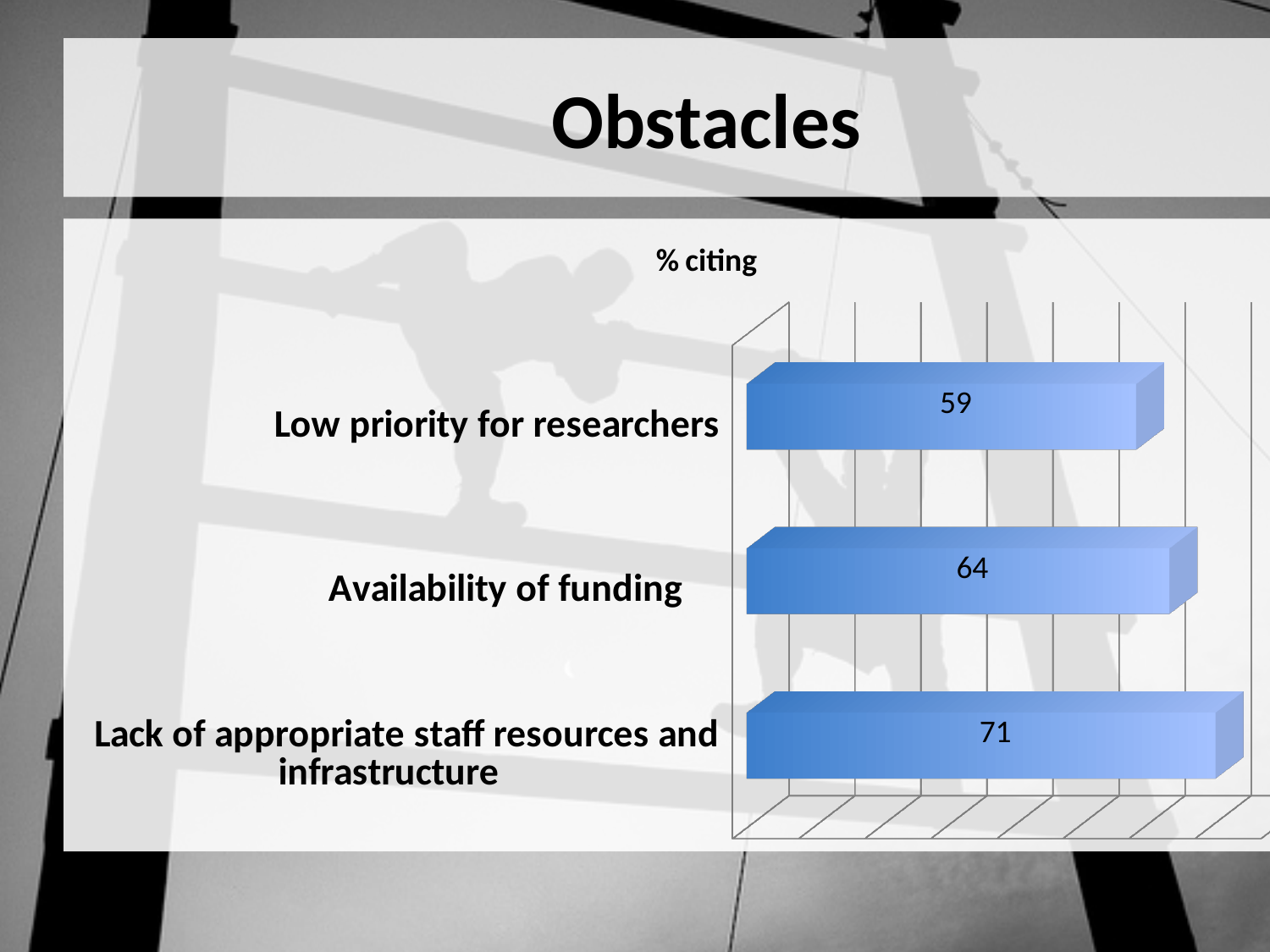
What is the title of the chart? % citing What is the difference between the values for Lack of appropriate staff resources and infrastructure and Low priority for researchers? 12 Which category has the lowest value? Low priority for researchers What is the value for Lack of appropriate staff resources and infrastructure? 71 What is the value for Availability of funding? 64 How many categories are shown in the chart? 3 Which category has the highest value? Lack of appropriate staff resources and infrastructure What colour are the bars in the chart? Blue What kind of chart is shown on the slide? Bar chart What is the difference between the values for Availability of funding and Low priority for researchers? 5 Which is larger, the value for Availability of funding or the value for Low priority for researchers? Availability of funding What is the value for Low priority for researchers? 59